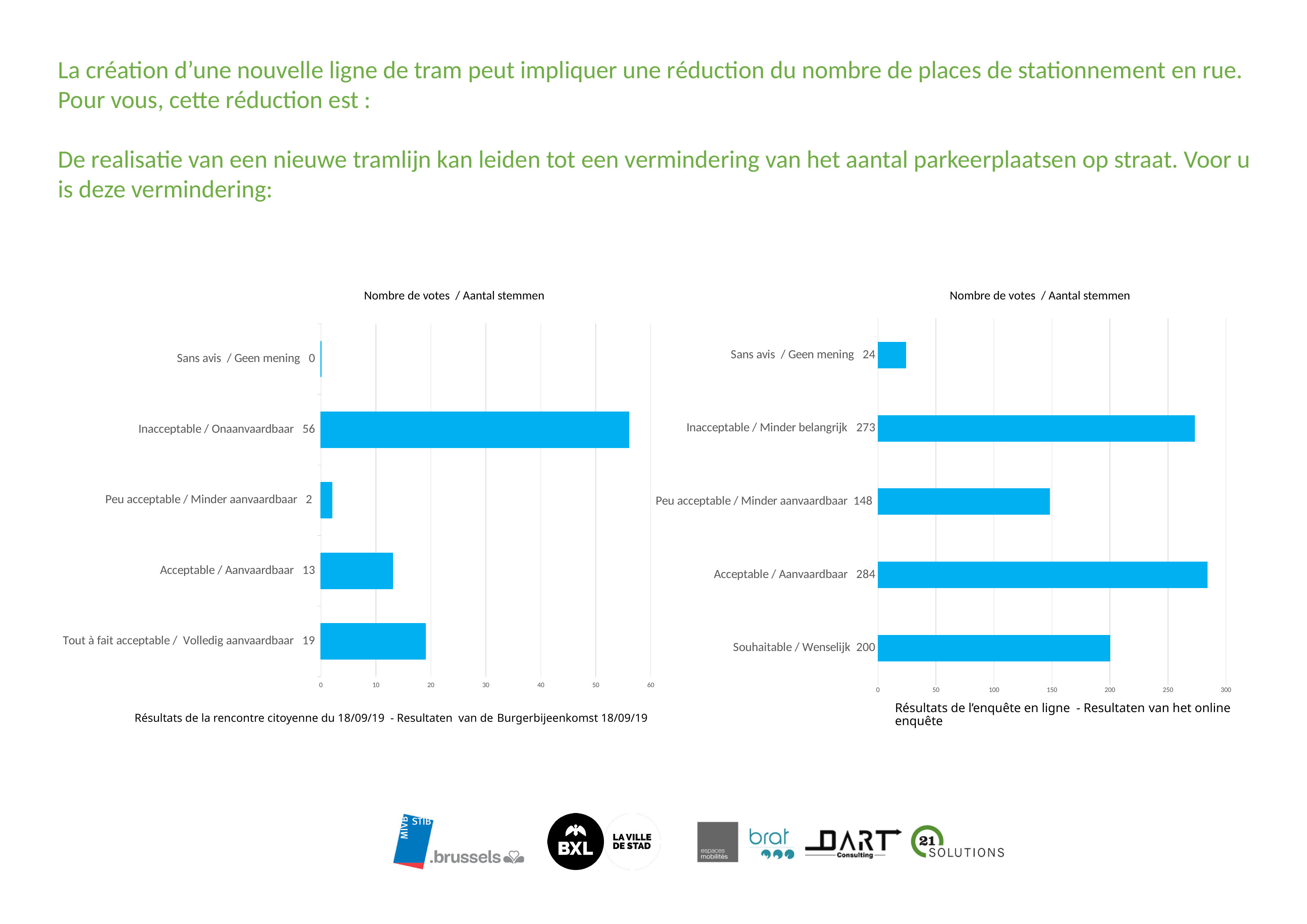
In the left chart (rencontre citoyenne), how many votes did 'Tout à fait acceptable / Volledig aanvaardbaar' receive? 19 In the right chart (Résultats de l'enquête en ligne), how many votes did 'Acceptable / Aanvaardbaar' receive? 284 In the left chart (Résultats de la rencontre citoyenne du 18/09/19), how many votes did 'Inacceptable / Onaanvaardbaar' receive? 56 In the right chart (enquête en ligne), which category has the lowest number of votes? Sans avis / Geen mening In the left chart (rencontre citoyenne), which category has the highest number of votes? Inacceptable / Onaanvaardbaar How many categories are shown in the right chart (enquête en ligne)? 5 In the right chart (enquête en ligne), which has more votes: 'Inacceptable / Minder belangrijk' or 'Peu acceptable / Minder aanvaardbaar'? Inacceptable / Minder belangrijk In the right chart (enquête en ligne), how many votes did 'Souhaitable / Wenselijk' receive? 200 In the right chart (enquête en ligne), what is the difference in votes between 'Acceptable / Aanvaardbaar' and 'Inacceptable / Minder belangrijk'? 11 In the left chart (rencontre citoyenne), which category has the lowest number of votes? Sans avis / Geen mening What type of chart is used on the left side of the slide (rencontre citoyenne)? Bar chart In the left chart (rencontre citoyenne), what is the difference in votes between 'Tout à fait acceptable / Volledig aanvaardbaar' and 'Acceptable / Aanvaardbaar'? 6